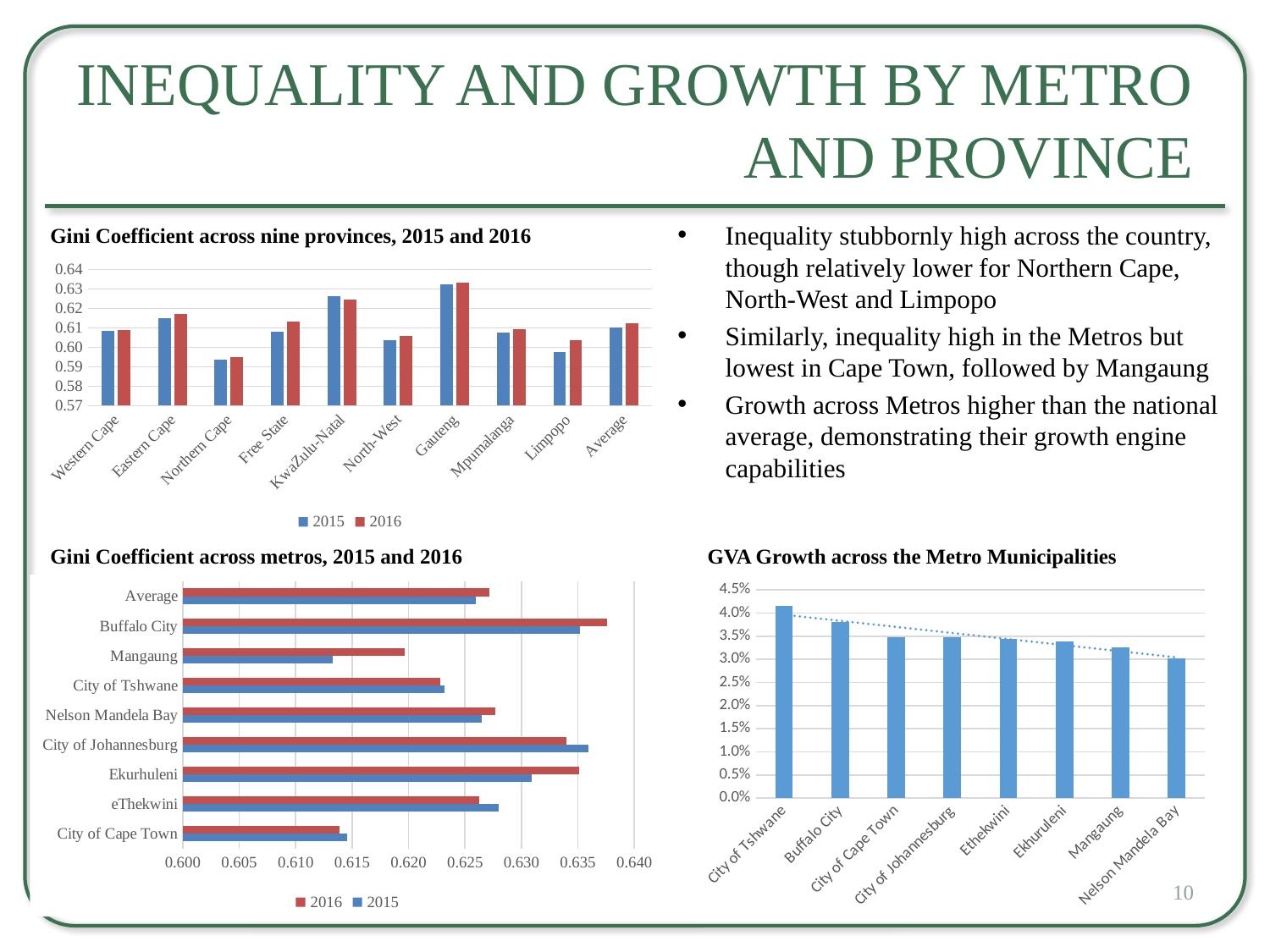
What type of chart is the 'Gini Coefficient across nine provinces, 2015 and 2016' chart? Bar chart In the 'Gini Coefficient across metros, 2015 and 2016' chart, which metro has the lowest Gini coefficient in 2015? Mangaung In the 'GVA Growth across the Metro Municipalities' chart, do the values rise or fall from left to right along the x axis? fall In the 'Gini Coefficient across metros, 2015 and 2016' chart, is the 2016 value for Mangaung larger or smaller than its 2015 value? larger In the 'GVA Growth across the Metro Municipalities' chart, is the value for City of Tshwane greater or less than 4.0%? greater In the 'Gini Coefficient across nine provinces, 2015 and 2016' chart, which province has the lowest Gini coefficient in 2016? Northern Cape In the 'Gini Coefficient across nine provinces, 2015 and 2016' chart, which province has the highest Gini coefficient in 2016? Gauteng In the 'Gini Coefficient across nine provinces, 2015 and 2016' chart, is the 2015 value for KwaZulu-Natal greater or less than 0.62? greater In the 'Gini Coefficient across nine provinces, 2015 and 2016' chart, how many categories are shown on the x axis? 10 In the 'Gini Coefficient across metros, 2015 and 2016' chart, which metro has the highest Gini coefficient in 2016? Buffalo City In the 'Gini Coefficient across nine provinces, 2015 and 2016' chart, how many series does the legend list? 2 In the 'GVA Growth across the Metro Municipalities' chart, which metro has the highest GVA growth? City of Tshwane